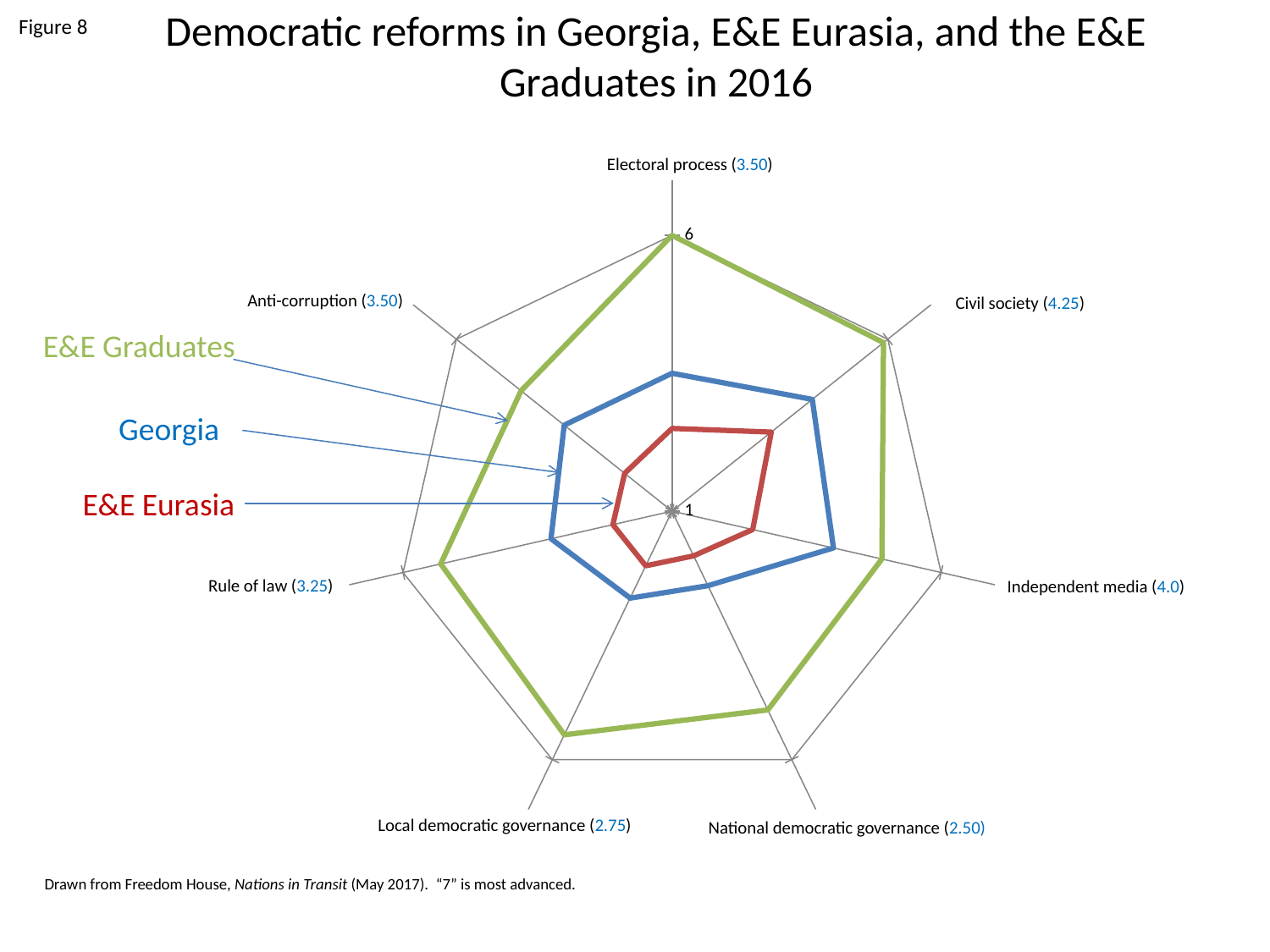
What is Georgia's score for Independent media? 4.0 Which series has the higher value for Civil society, Georgia or E&E Graduates? E&E Graduates What is Georgia's score for National democratic governance? 2.50 On which dimension does Georgia score lowest? National democratic governance How many series are plotted on the chart? 3 On which dimension does Georgia score highest? Civil society What is the difference between Georgia's Civil society score and its National democratic governance score? 1.75 What kind of chart is shown on the slide? Radar chart Which series has the higher value for Independent media, Georgia or E&E Eurasia? Georgia How many dimensions (axes) does the chart show? 7 What is Georgia's score for Civil society? 4.25 What is Georgia's score for Rule of law? 3.25